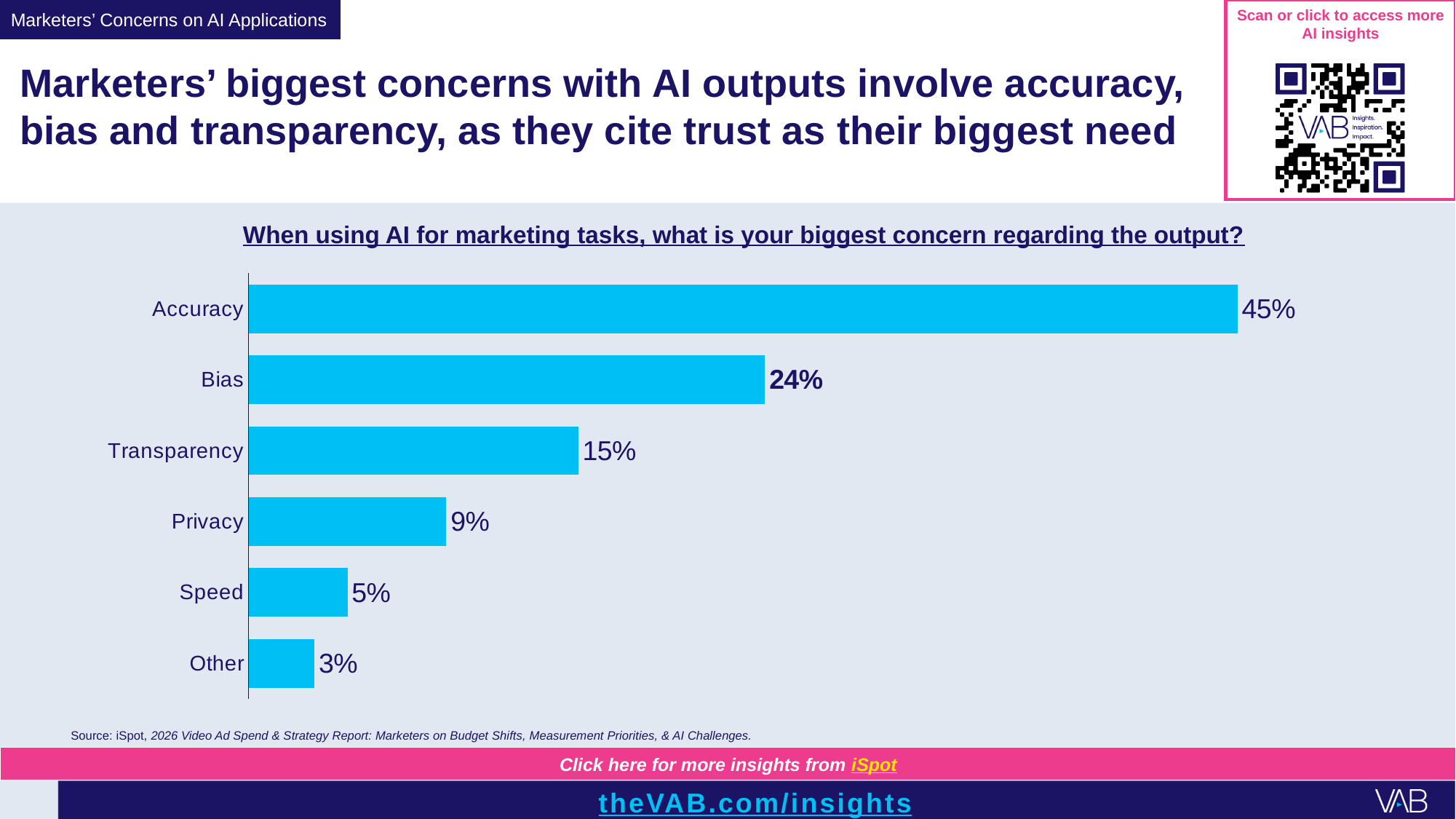
What is the difference between the values for Accuracy and Bias? 21% What is the difference between the values for Speed and Other? 2% What percentage of marketers cite Accuracy as their biggest concern regarding AI output? 45% What is the value shown for Privacy? 9% Which concern has the highest value in the chart? Accuracy What question is the chart titled with? When using AI for marketing tasks, what is your biggest concern regarding the output? Which category has the lowest value in the chart? Other Which has a larger value, Transparency or Privacy? Transparency What is the value shown for Transparency? 15% How many categories are shown in the chart? 6 What is the value shown for Bias? 24% What kind of chart is shown on the slide? Bar chart